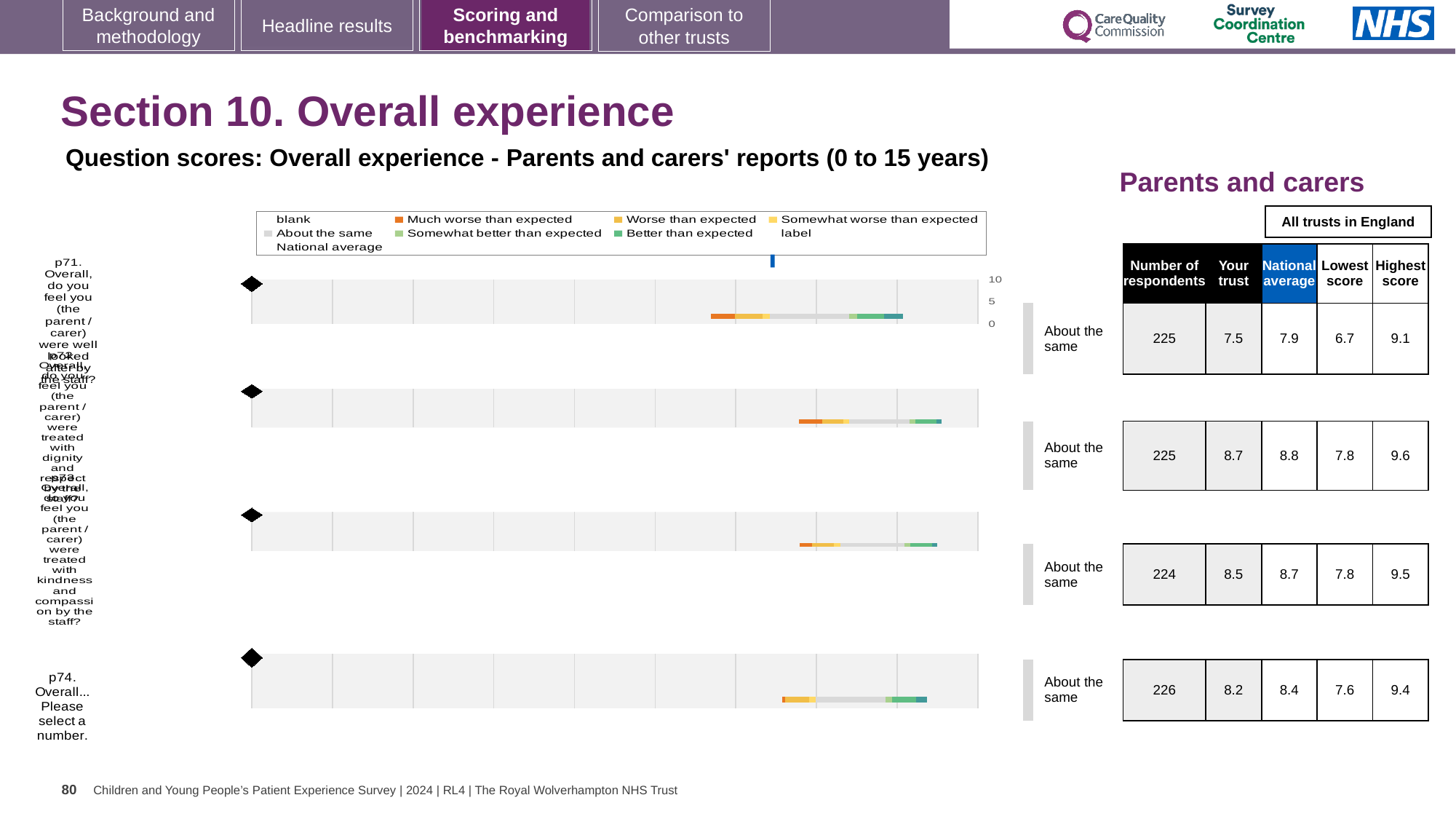
What colour does the legend use for 'Much worse than expected'? orange Which row has the highest 'Your trust' score in the table beside the chart? the second row from the top (p72) In the table beside the chart, what is the 'Highest score' for the top row (p71)? 9.1 In the table beside the chart, what is the 'Your trust' score for the bottom row (p74. Overall... Please select a number.)? 8.2 Which row has the lowest 'Your trust' score in the table beside the chart? the top row (p71) For the top row (p71), which is larger in the table: the 'Your trust' score or the 'National average'? National average What benchmark label is shown to the right of every bar in the chart? About the same In the table beside the chart, how many respondents are listed for the bottom row (p74)? 226 What kind of chart is shown on the slide? bar chart How many entries does the chart's legend list? 9 For the top row (p71), what is the difference between the 'National average' (7.9) and the 'Your trust' score (7.5)? 0.4 How many question rows (bars) does the chart contain? 4